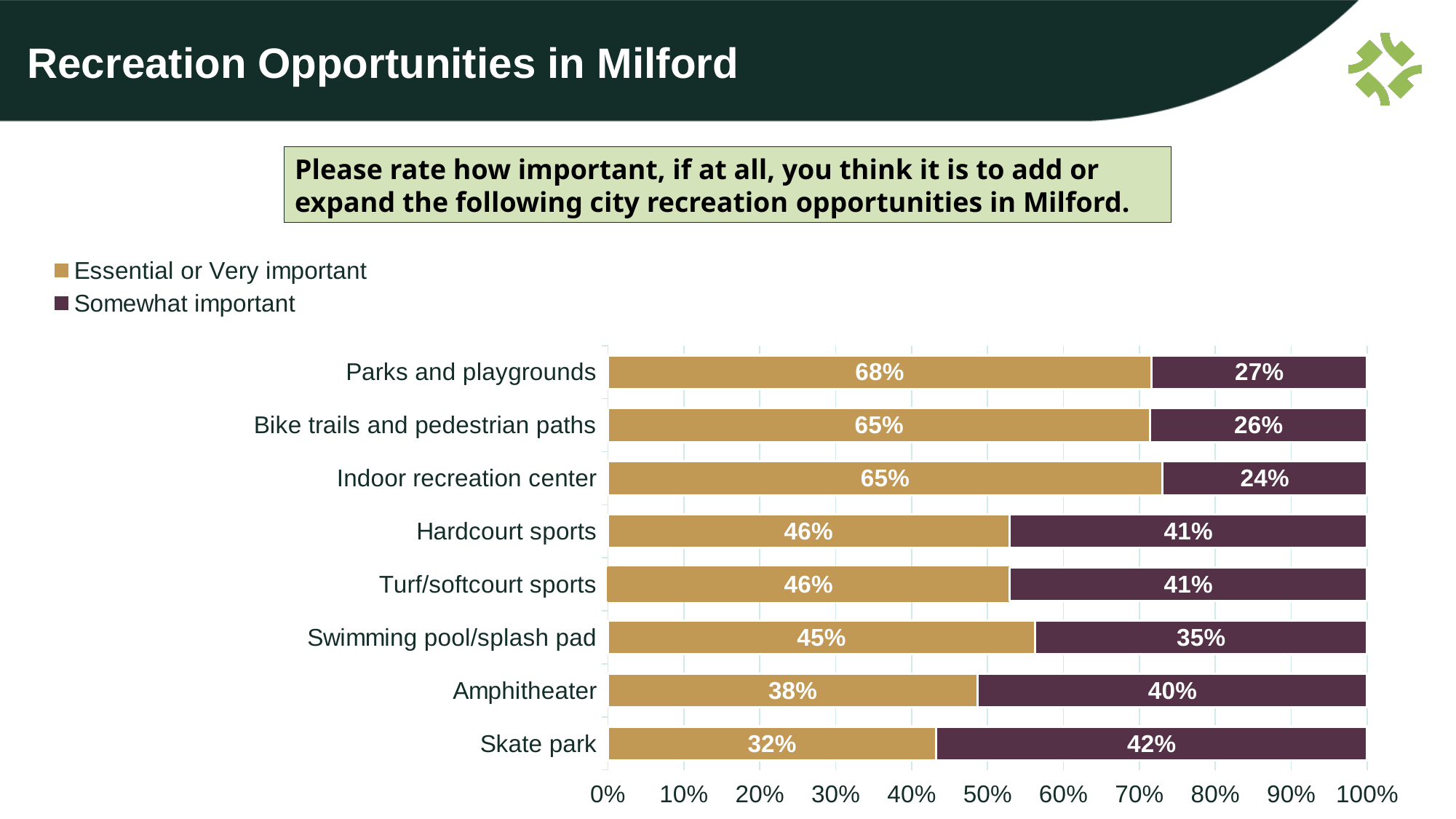
Which category has the lowest Somewhat important percentage? Indoor recreation center Which is larger for Amphitheater: the Essential or Very important share or the Somewhat important share? Somewhat important What percentage rated Parks and playgrounds as Essential or Very important? 68% How many series does the legend list? 2 What is the Somewhat important value for Swimming pool/splash pad? 35% How many recreation opportunities are listed in the chart? 8 Which recreation opportunity has the highest Essential or Very important percentage? Parks and playgrounds What percentage rated Skate park as Somewhat important? 42% What is the difference between the Essential or Very important percentages for Parks and playgrounds and Skate park? 36% Which recreation opportunity has the lowest Essential or Very important percentage? Skate park What is the combined Essential or Very important and Somewhat important total for Hardcourt sports? 87% What type of chart is shown on the slide? Stacked bar chart